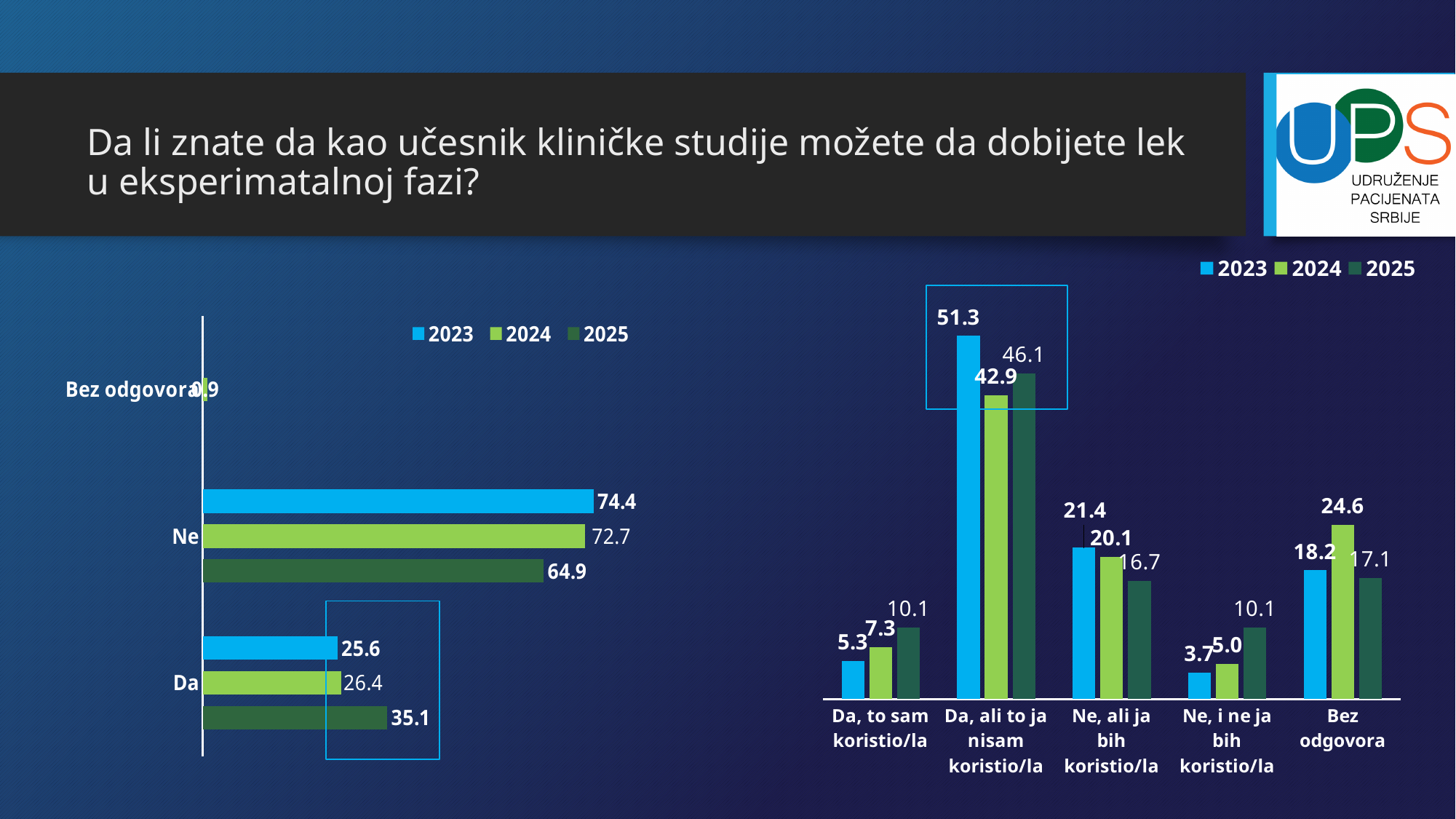
In the right chart, what is the 2023 value for 'Da, ali to ja nisam koristio/la'? 51.3 In the right chart, what is the 2024 value for 'Bez odgovora'? 24.6 In the left chart, which is larger for 'Da': the 2024 value or the 2025 value? 2025 In the right chart, which category has the highest 2025 value? Da, ali to ja nisam koristio/la In the left chart, what is the value for 'Ne' in 2023? 74.4 In the right chart, what is the difference between the 2025 and 2023 values for 'Ne, i ne ja bih koristio/la'? 6.4 In the left chart, what is the value for 'Da' in 2025? 35.1 In the right chart, which category has the lowest 2023 value? Ne, i ne ja bih koristio/la In the right chart, how many categories are shown on the x axis? 5 What kind of chart is the left chart? bar chart In the left chart, what is the difference between the 2023 and 2025 values for 'Ne'? 9.5 In the left chart, how many series does the legend list? 3